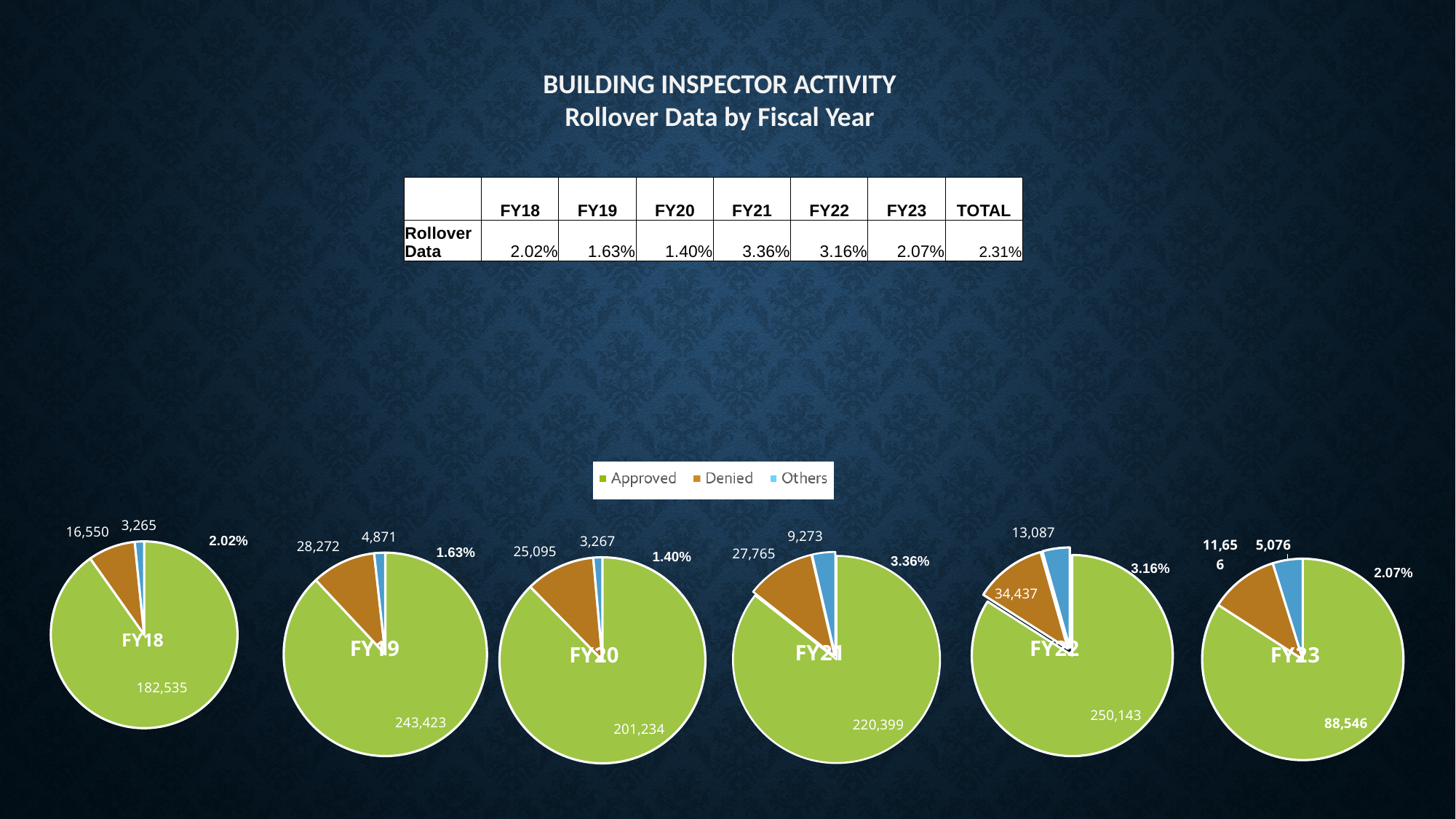
How many series does the legend above the pie charts list? 3 In the FY20 pie chart, which slice is the largest? Approved In the FY22 pie chart, what is the value of the Denied slice? 34,437 In the FY21 pie chart, what is the value of the Others slice? 9,273 In the FY23 pie chart, what is the value of the Approved slice? 88,546 In the FY19 pie chart, which slice is the smallest? Others How many pie charts are shown on the slide? 6 What kind of charts are shown at the bottom of the slide? Pie charts In the FY20 pie chart, what is the difference between the Denied and Others values? 21,828 Which colour represents Denied in the pie charts' legend? Orange In the FY18 pie chart, what is the value of the Approved slice? 182,535 Which is larger: the Denied slice in the FY22 pie chart or the Denied slice in the FY18 pie chart? FY22